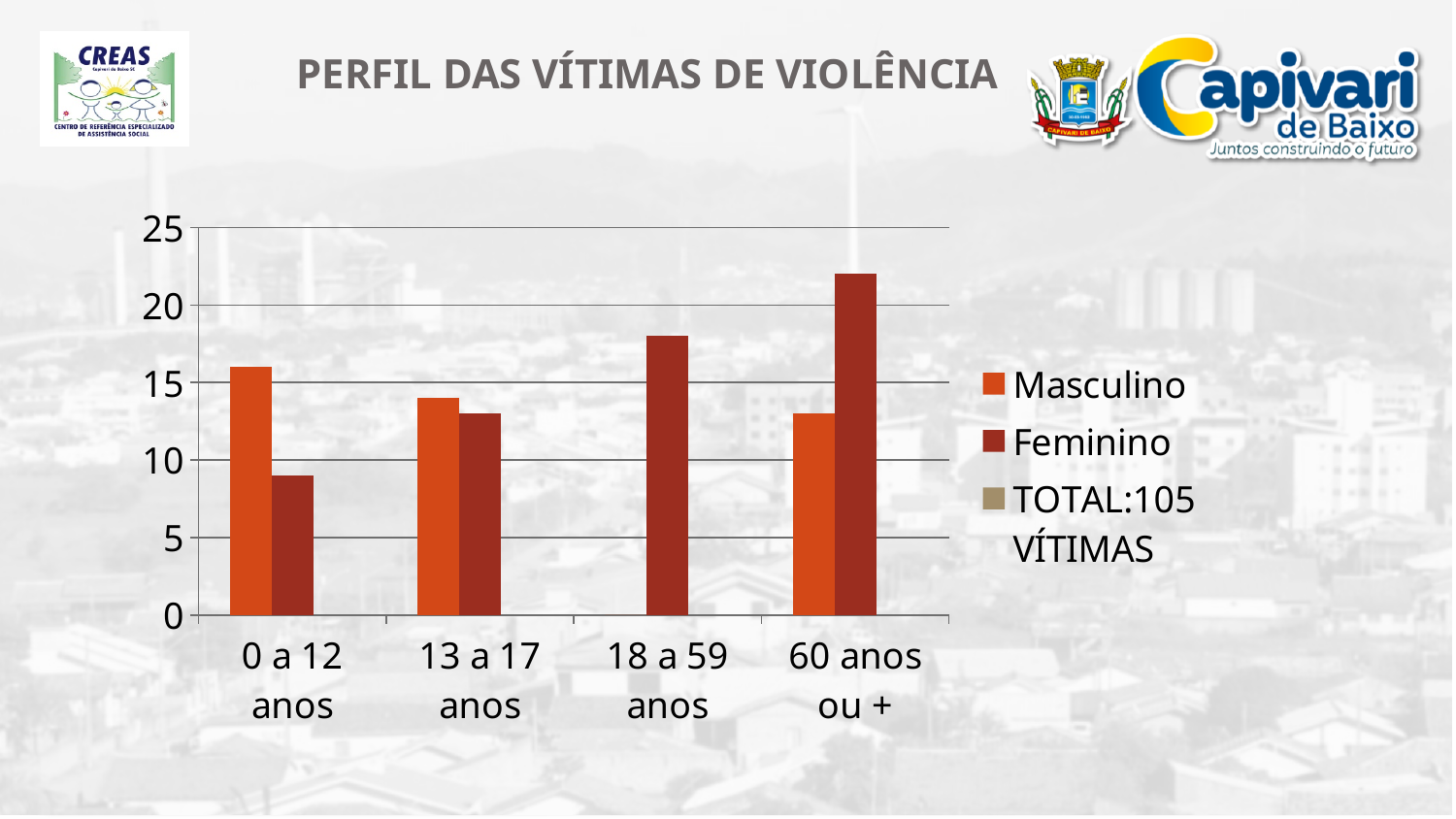
How many age-group categories are shown on the x axis? 4 Which age group has the lowest Feminino value? 0 a 12 anos Which age group has the highest Feminino value? 60 anos ou + In the 60 anos ou + group, which is larger, Masculino or Feminino? Feminino Is the Feminino value for 60 anos ou + greater or less than 20? greater What kind of chart is shown on the slide? bar chart Is the Masculino value for 60 anos ou + greater or less than 10? greater In the 0 a 12 anos group, which is larger, Masculino or Feminino? Masculino What is the title of the chart? PERFIL DAS VÍTIMAS DE VIOLÊNCIA How many entries does the legend list? 3 Is the Feminino value for 18 a 59 anos greater or less than 15? greater What total number of victims does the legend state? 105